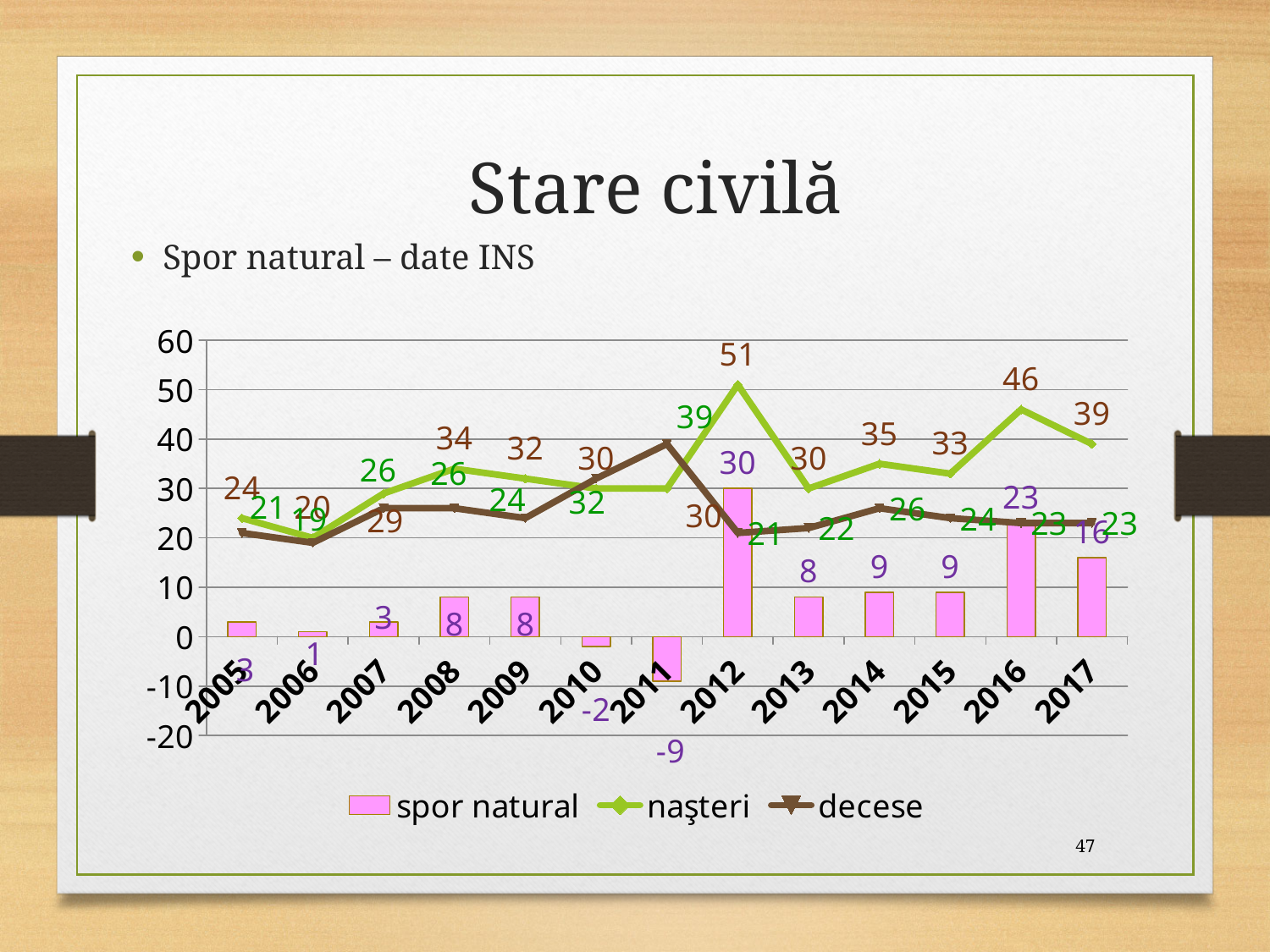
What is the value of spor natural in 2011? -9 What is the difference between naşteri and decese in 2016? 23 How many series does the legend list? 3 Which series is drawn as pink bars? spor natural What type of chart is shown on the slide? combined bar and line chart Is the value of naşteri in 2016 greater or less than 40? greater What is the value of naşteri in 2012? 51 In which year is spor natural the highest? 2012 Which is larger in 2010, naşteri or decese? decese In which year is spor natural the lowest? 2011 How many years are shown on the x axis? 13 What is the value of decese in 2017? 23